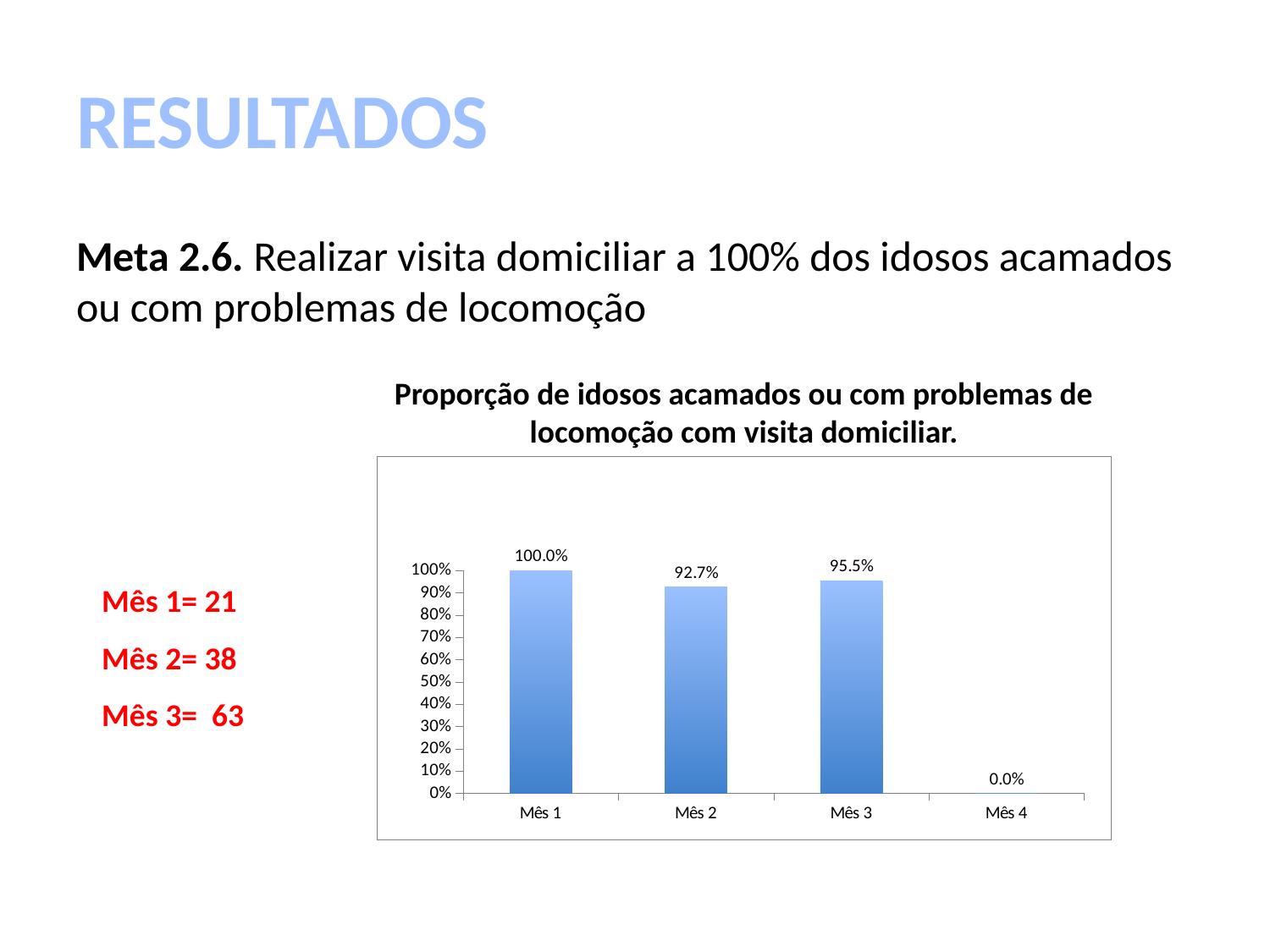
What is the difference between the values for Mês 3 and Mês 2? 2.8% What kind of chart is shown? Bar chart How many categories are shown on the x axis? 4 What is the value for Mês 1? 100.0% Which is larger, the value for Mês 2 or Mês 3? Mês 3 Which category has the lowest value? Mês 4 What is the title of the chart? Proporção de idosos acamados ou com problemas de locomoção com visita domiciliar. What is the value for Mês 4? 0.0% What is the value for Mês 3? 95.5% What is the difference between the values for Mês 1 and Mês 2? 7.3% What is the value for Mês 2? 92.7% Which category has the highest value? Mês 1